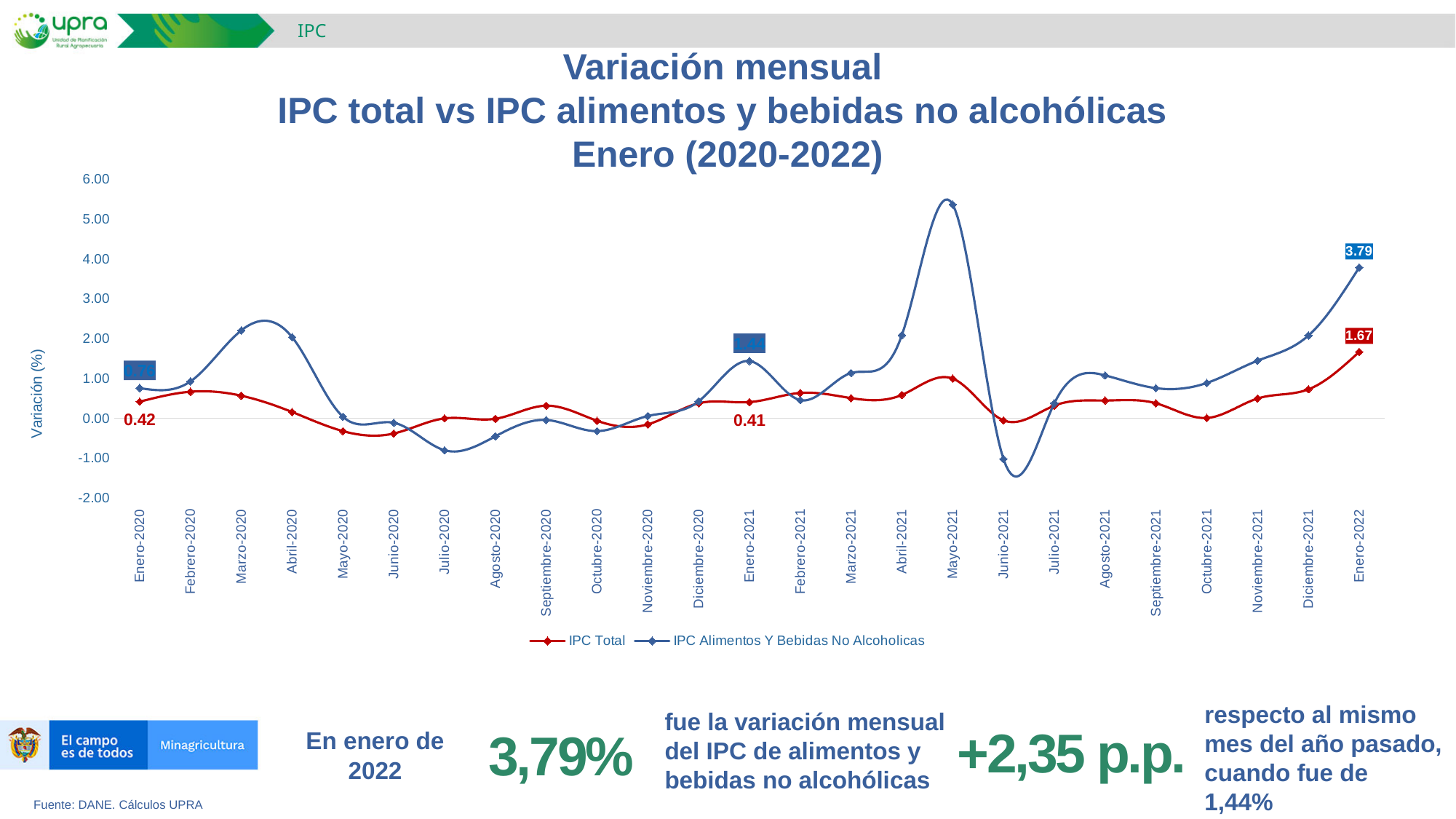
What is the value of IPC Total for Enero-2022? 1.67 In which month does the IPC Alimentos Y Bebidas No Alcoholicas series reach its highest value? Mayo-2021 How many months are plotted along the x axis? 25 Does the IPC Alimentos Y Bebidas No Alcoholicas series rise or fall from Junio-2021 to Enero-2022? Rise What kind of chart is shown on the slide? Line chart What is the value of IPC Alimentos Y Bebidas No Alcoholicas for Enero-2022? 3.79 What is the value of IPC Total for Enero-2020? 0.42 How many series does the legend list? 2 What is the value of IPC Total for Enero-2021? 0.41 Is the IPC Alimentos Y Bebidas No Alcoholicas value for Junio-2021 greater or less than 0.00? less Is the IPC Alimentos Y Bebidas No Alcoholicas value for Mayo-2021 greater or less than 5.00? greater What is the difference between the IPC Alimentos Y Bebidas No Alcoholicas value and the IPC Total value for Enero-2022? 2.12